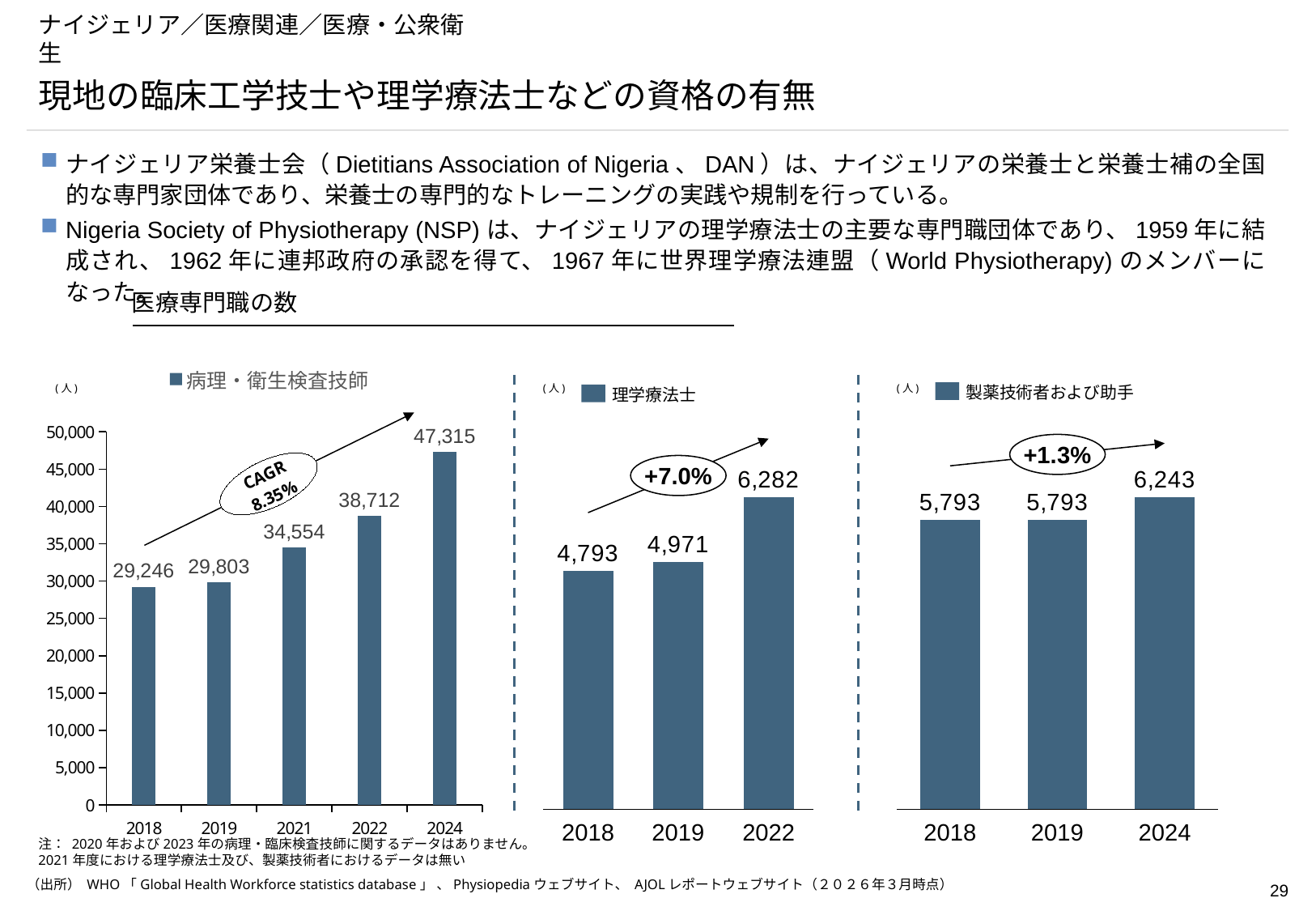
「理学療法士」のグラフで、最も値が高い年はどれですか？ 2022 「病理・衛生検査技師」のグラフで、最も値が低い年はどれですか？ 2018 「病理・衛生検査技師」のグラフで、2024年の値はいくつですか？ 47,315 「理学療法士」のグラフで、2019年の値はいくつですか？ 4,971 「製薬技術者および助手」のグラフはどの種類のグラフですか？ 棒グラフ 「製薬技術者および助手」のグラフで、2024年の値はいくつですか？ 6,243 「病理・衛生検査技師」のグラフで、値は年を追うごとに増加していますか、減少していますか？ 増加 「病理・衛生検査技師」のグラフに示されているCAGRはいくつですか？ 8.35% 「製薬技術者および助手」のグラフで、2018年と2019年の値はどちらが大きいですか？ 同じ（5,793） 「病理・衛生検査技師」のグラフには、いくつの年（カテゴリ）が表示されていますか？ 5 「病理・衛生検査技師」のグラフで、2022年と2021年の値の差はいくつですか？ 4,158 「理学療法士」のグラフで、2022年と2018年の値の差はいくつですか？ 1,489